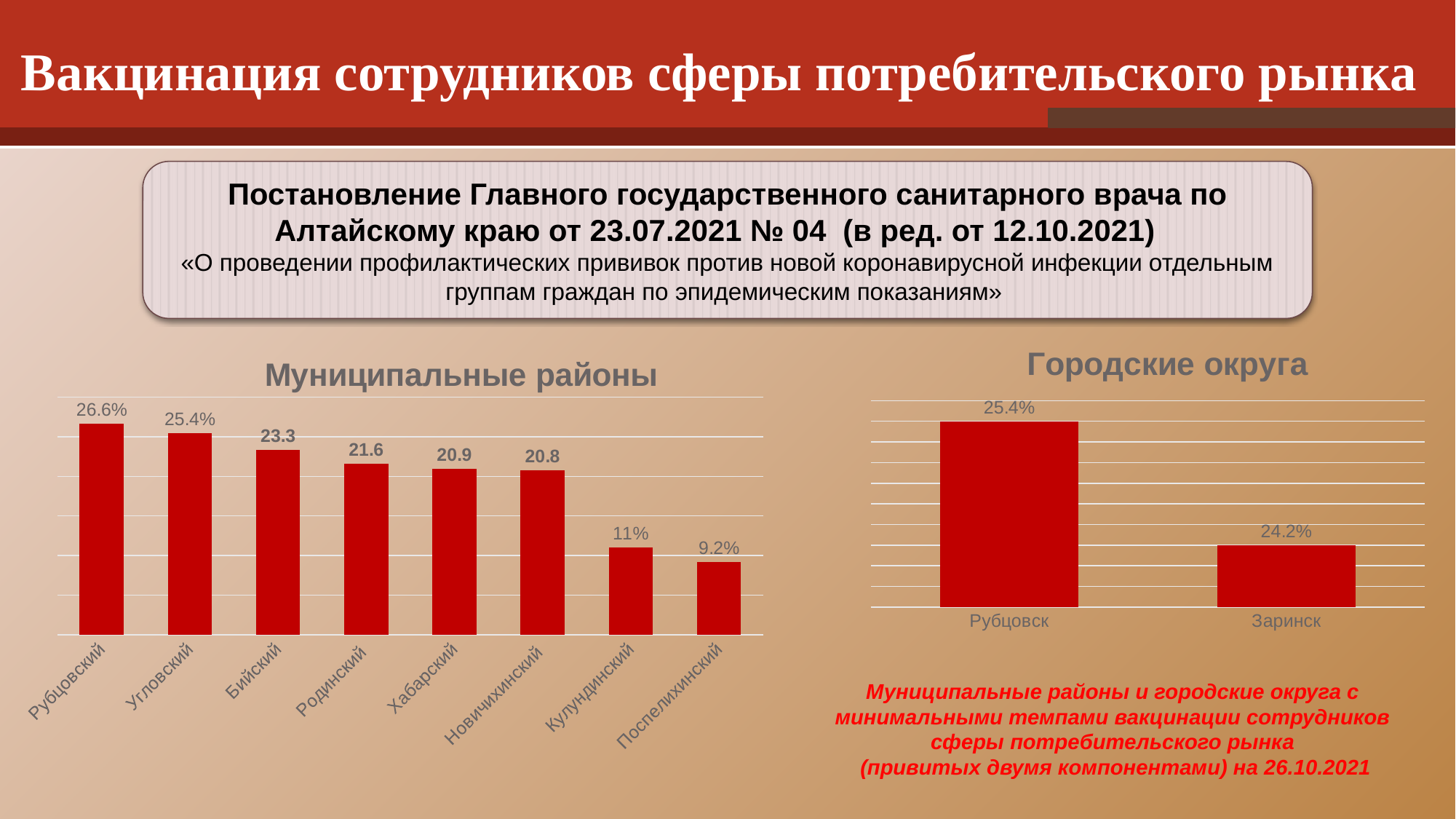
In the 'Муниципальные районы' chart, which category has the highest value? Рубцовский What kind of chart is the 'Городские округа' chart? bar chart In the 'Городские округа' chart, what is the difference between the values for Рубцовск and Заринск? 1.2% In the 'Городские округа' chart, what is the value for Заринск? 24.2% In the 'Муниципальные районы' chart, which category has the lowest value? Поспелихинский In the 'Муниципальные районы' chart, what is the value for Кулундинский? 11% In the 'Муниципальные районы' chart, do the values rise or fall from left to right along the x axis? fall In the 'Муниципальные районы' chart, what is the value for Рубцовский? 26.6% In the 'Муниципальные районы' chart, what is the value for Бийский? 23.3 In the 'Муниципальные районы' chart, how many categories are shown? 8 In the 'Муниципальные районы' chart, what is the difference between the values for Рубцовский and Угловский? 1.2% In the 'Городские округа' chart, which is larger, Рубцовск or Заринск? Рубцовск